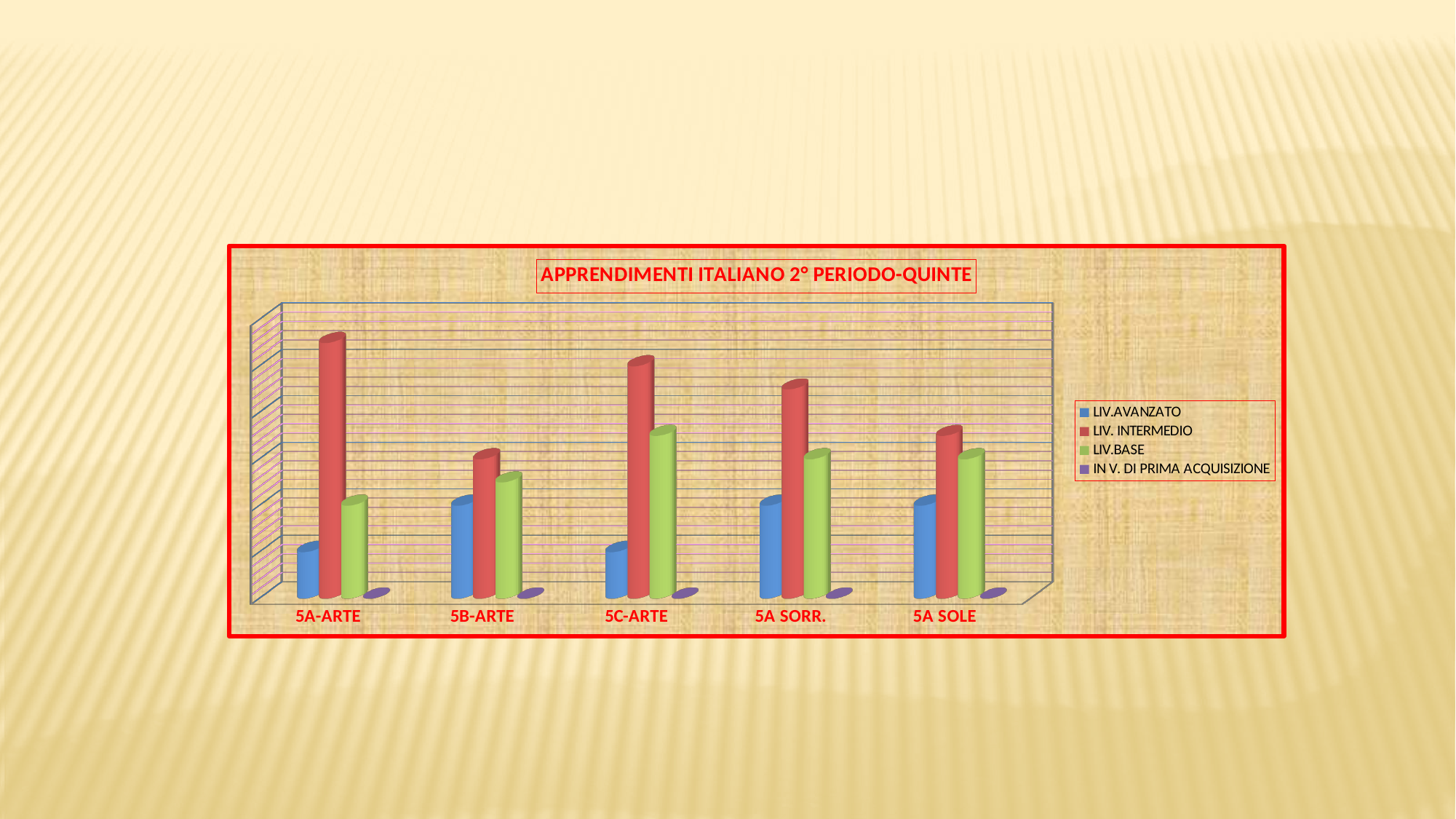
Which series is shown in purple in the legend? IN V. DI PRIMA ACQUISIZIONE Which category has the highest LIV. INTERMEDIO bar? 5A-ARTE Which category has the lowest LIV. INTERMEDIO bar? 5B-ARTE How many series does the legend list? 4 In 5A-ARTE, which is larger: LIV. INTERMEDIO or LIV.BASE? LIV. INTERMEDIO What is the title of the chart? APPRENDIMENTI ITALIANO 2° PERIODO-QUINTE Which category has the highest LIV.BASE bar? 5C-ARTE Which category has the lowest LIV.BASE bar? 5A-ARTE In 5B-ARTE, which is larger: LIV.AVANZATO or LIV.BASE? LIV.BASE Which series has the tallest bar in every category? LIV. INTERMEDIO What kind of chart is shown on the slide? bar chart How many categories (classes) are shown on the x axis? 5